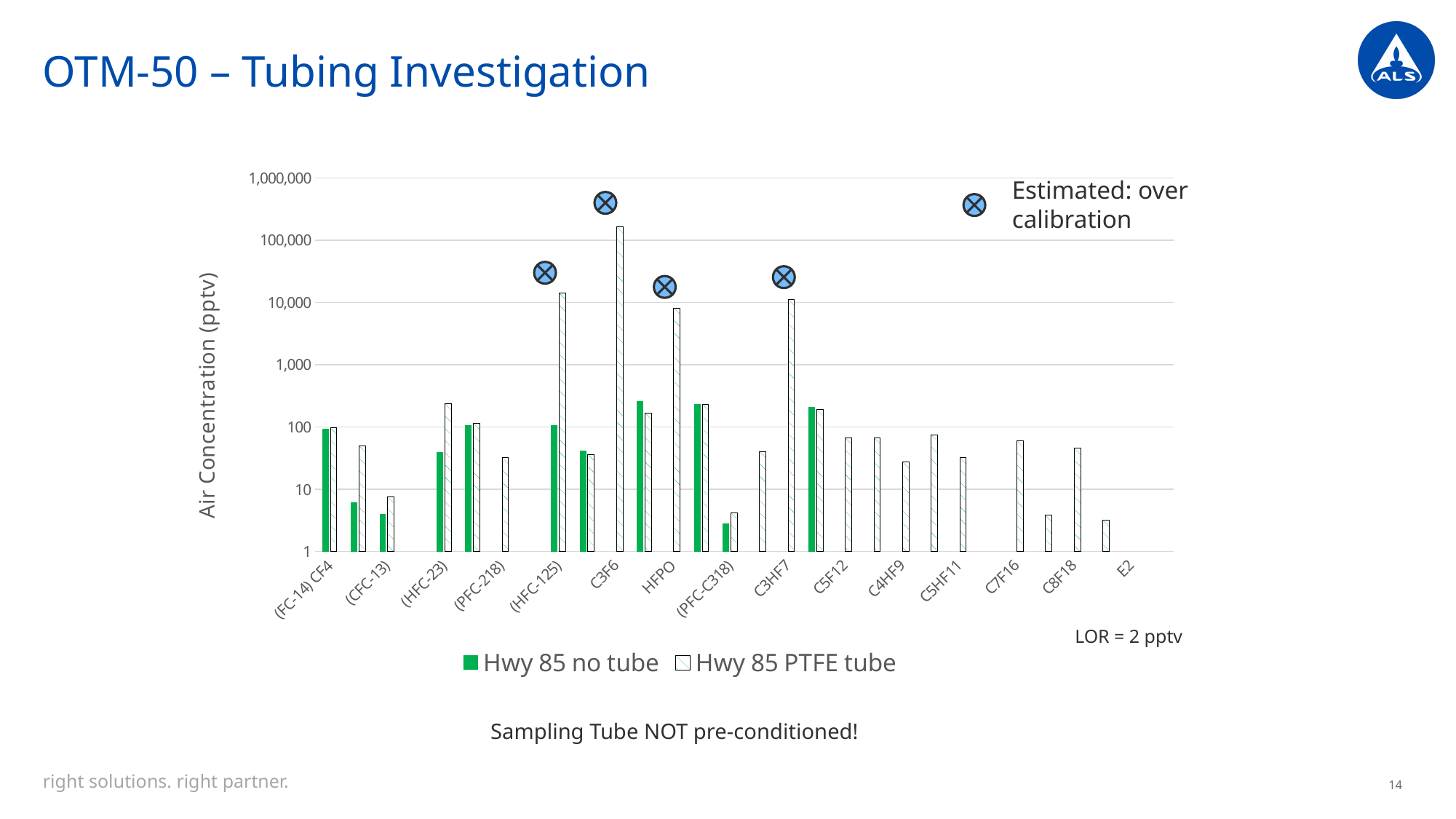
For (HFC-23), which series has the larger value, Hwy 85 no tube or Hwy 85 PTFE tube? Hwy 85 PTFE tube Which series has the highest bar on the chart, Hwy 85 no tube or Hwy 85 PTFE tube? Hwy 85 PTFE tube What is the title of the y-axis of the chart? Air Concentration (pptv) What are the two series named in the chart legend? Hwy 85 no tube and Hwy 85 PTFE tube Is the Hwy 85 PTFE tube value for C5F12 greater or less than 100? less Is the Hwy 85 PTFE tube value for C3F6 greater or less than 100,000? greater Which category has the highest bar on the chart? C3F6 What is the highest tick value shown on the y-axis of the chart? 1,000,000 How many bars on the chart are marked with the 'Estimated: over calibration' symbol? 4 How many series does the chart legend list? 2 What type of chart is shown on the slide? Bar chart